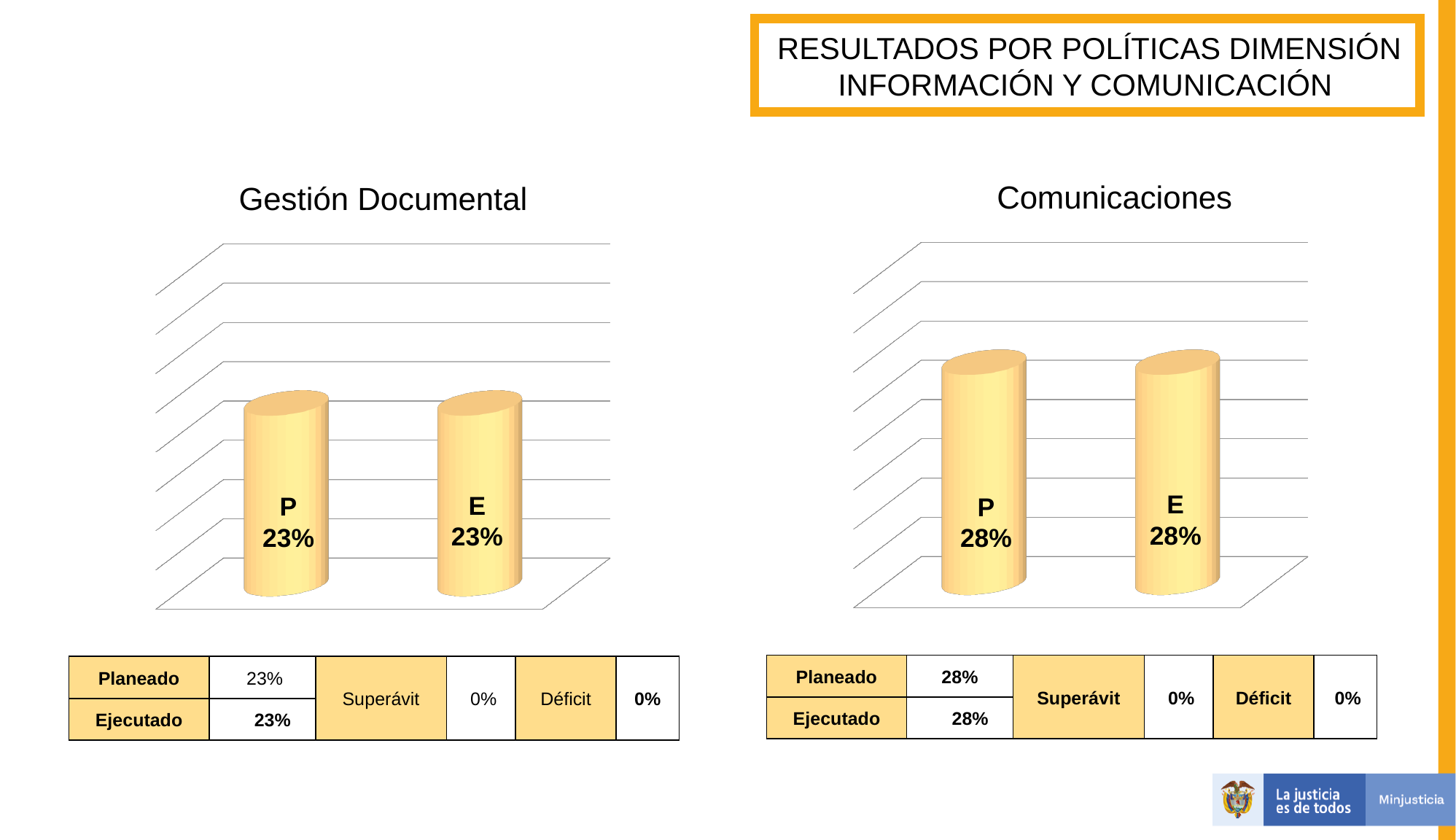
In the Gestión Documental chart, what is the value for E? 23% How many bars are plotted in the Comunicaciones chart? 2 What kind of chart is the Gestión Documental chart? Bar chart What is the title of the chart on the right side of the slide? Comunicaciones In the Comunicaciones chart, what is the difference between the P and E values? 0% What kind of chart is the Comunicaciones chart? Bar chart In the Comunicaciones chart, what is the value for E? 28% What is the title of the chart on the left side of the slide? Gestión Documental In the Comunicaciones chart, what is the value for P? 28% In the Gestión Documental chart, what is the difference between the P and E values? 0% How many bars are plotted in the Gestión Documental chart? 2 In the Gestión Documental chart, what is the value for P? 23%